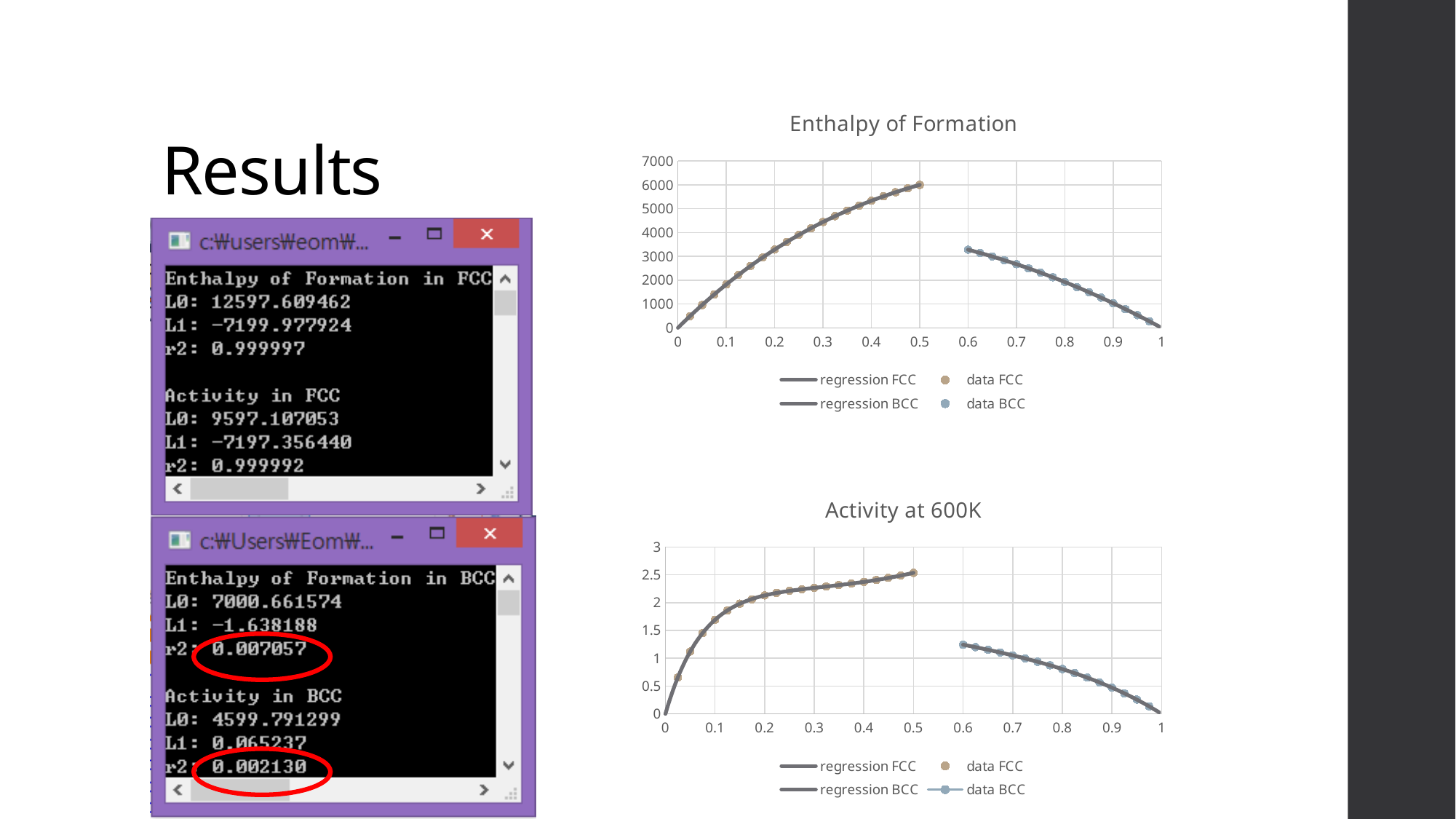
In the "Activity at 600K" chart, is the BCC value at x = 0.6 greater or less than 1.5? less In the "Activity at 600K" chart, do the BCC values rise or fall as x increases from 0.6 to 1? fall How many series does the legend of the "Activity at 600K" chart list? 4 In the "Enthalpy of Formation" chart, is the FCC value at x = 0.5 greater or less than 5000? greater In the "Enthalpy of Formation" chart, do the BCC values rise or fall as x increases from 0.6 to 1? fall What kind of chart is the "Enthalpy of Formation" chart? line chart with data points (scatter with regression lines) In the "Enthalpy of Formation" chart, which is larger: the FCC value at x = 0.5 or the BCC value at x = 0.6? the FCC value at x = 0.5 What are the legend entries of the "Activity at 600K" chart? regression FCC, data FCC, regression BCC, data BCC In the "Enthalpy of Formation" chart, do the FCC values rise or fall as x increases from 0 to 0.5? rise In the "Activity at 600K" chart, is the FCC value at x = 0.5 greater or less than 2? greater How many series does the legend of the "Enthalpy of Formation" chart list? 4